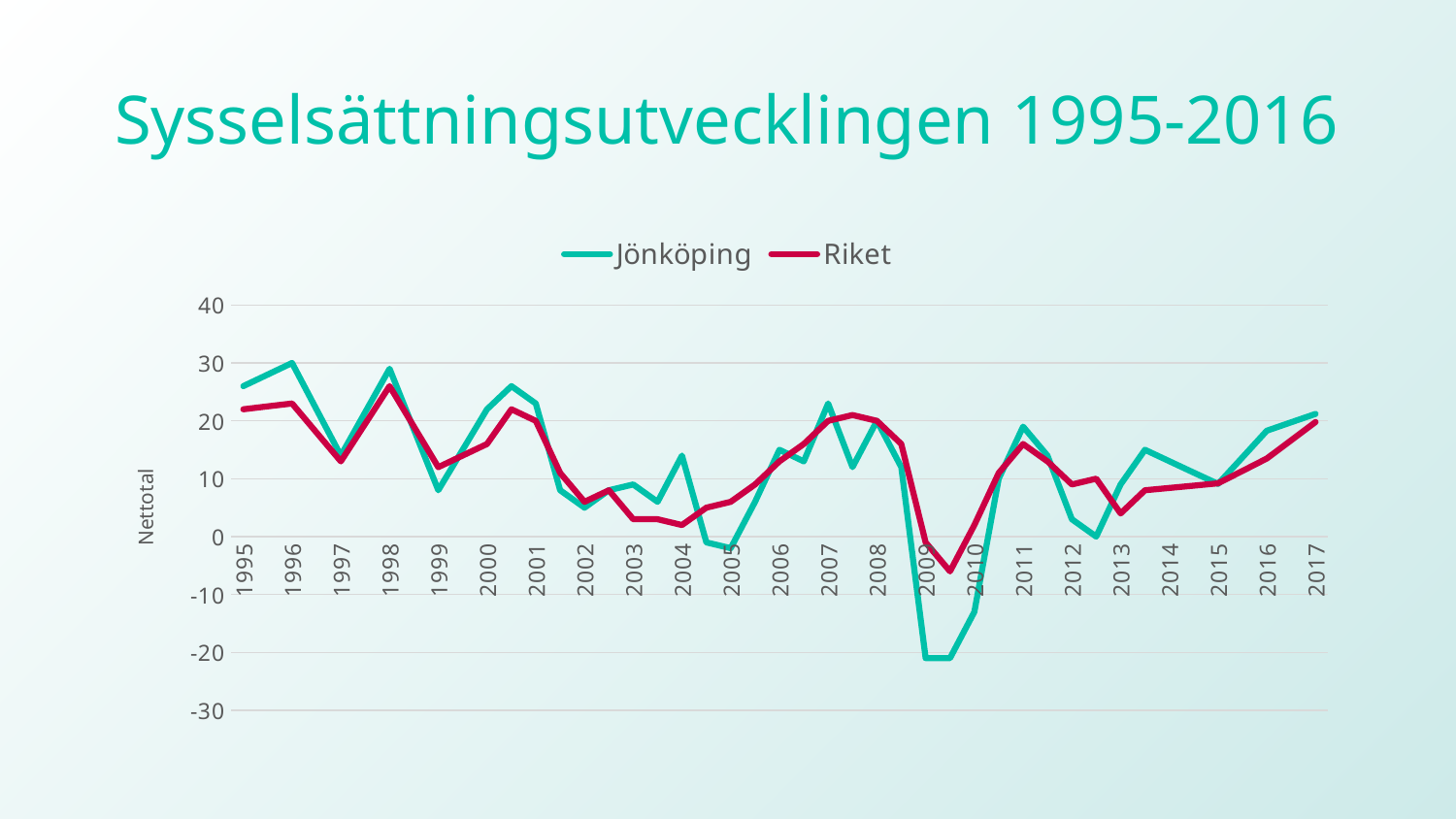
In which year does the Jönköping series reach its lowest value? 2009 How many years are labelled on the x axis? 23 Is the value for Riket in 2004 greater or less than 10? less Is the value for Jönköping in 1996 greater or less than 20? greater In 2004, which series has the larger value, Jönköping or Riket? Jönköping What kind of chart is shown on the slide? line chart In 2009, which series has the larger value, Jönköping or Riket? Riket How many series does the legend list? 2 What is the label on the y axis? Nettotal Is the value for Jönköping in 2009 greater or less than -10? less What is the title of the chart? Sysselsättningsutvecklingen 1995-2016